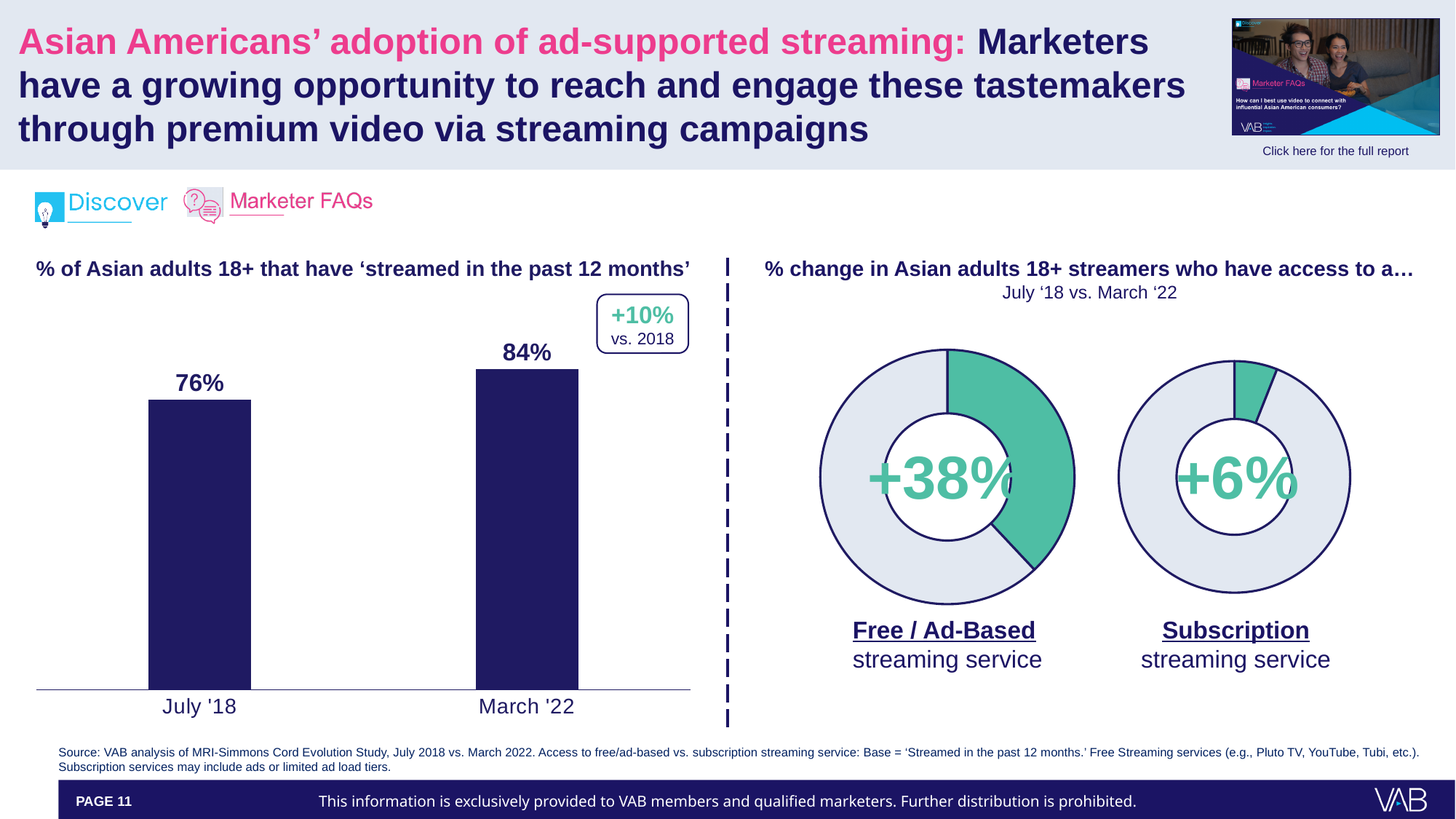
In the bar chart on the left, what is the difference between the March '22 and July '18 values? 8 percentage points What does the callout box next to the March '22 bar say the change is versus 2018? +10% What kind of chart is shown on the left side of the slide? Bar chart In the bar chart on the left, which period has the higher value? March '22 In the bar chart '% of Asian adults 18+ that have streamed in the past 12 months', what is the value for July '18? 76% In the donut charts on the right, what is the % change for Subscription streaming service? +6% In the bar chart on the left, which period has the lower value? July '18 In the bar chart '% of Asian adults 18+ that have streamed in the past 12 months', what is the value for March '22? 84% In the donut charts on the right, what is the % change for Free / Ad-Based streaming service? +38% In the bar chart on the left, do the values rise or fall from July '18 to March '22? Rise In the bar chart on the left, how many bars are plotted? 2 In the donut charts on the right, which streaming service type shows the larger % change? Free / Ad-Based streaming service